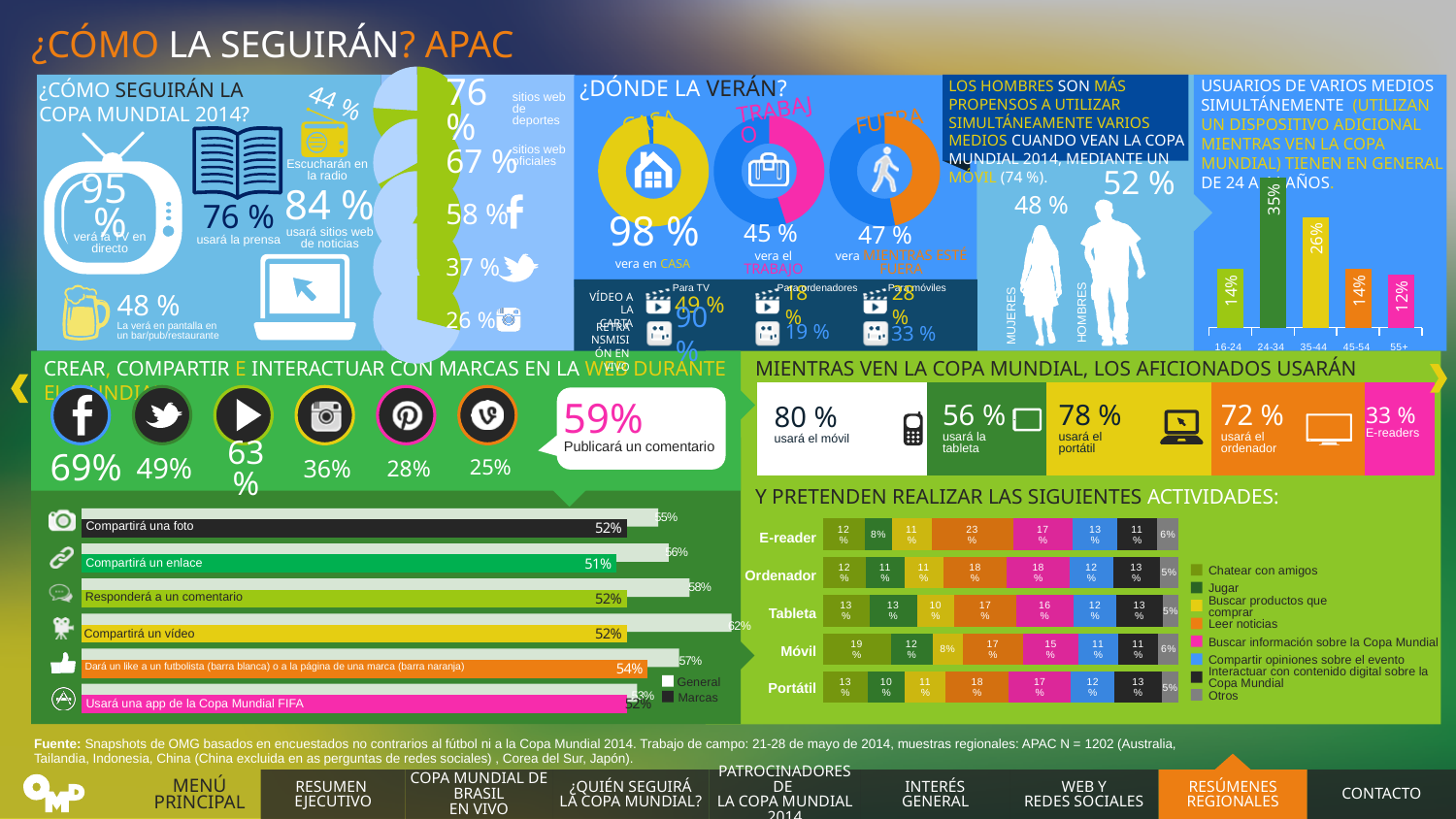
In the age-group bar chart at the top right, which age group has the lowest value? 55+ In the stacked bar chart 'Y pretenden realizar las siguientes actividades', how many activities does the legend list? 8 What kind of chart is 'Y pretenden realizar las siguientes actividades'? Stacked bar chart In the stacked bar chart 'Y pretenden realizar las siguientes actividades', what is the value for 'Leer noticias' on E-reader? 23% In the bar chart at the bottom left (Compartirá una foto, Compartirá un enlace, ...), how many series does the legend list? 2 In the age-group bar chart at the top right, what is the difference between the 24-34 and 35-44 values? 9 percentage points In the age-group bar chart at the top right, what is the value for the 24-34 age group? 35% In the stacked bar chart 'Y pretenden realizar las siguientes actividades', what is the value for 'Chatear con amigos' on Móvil? 19% In the stacked bar chart 'Y pretenden realizar las siguientes actividades', how many device categories are shown? 5 In the stacked bar chart 'Y pretenden realizar las siguientes actividades', which is larger: 'Chatear con amigos' on Móvil or 'Chatear con amigos' on Tableta? Móvil In the age-group bar chart at the top right (usuarios de varios medios simultáneamente), which age group has the highest value? 24-34 How many age groups are shown in the bar chart at the top right? 5